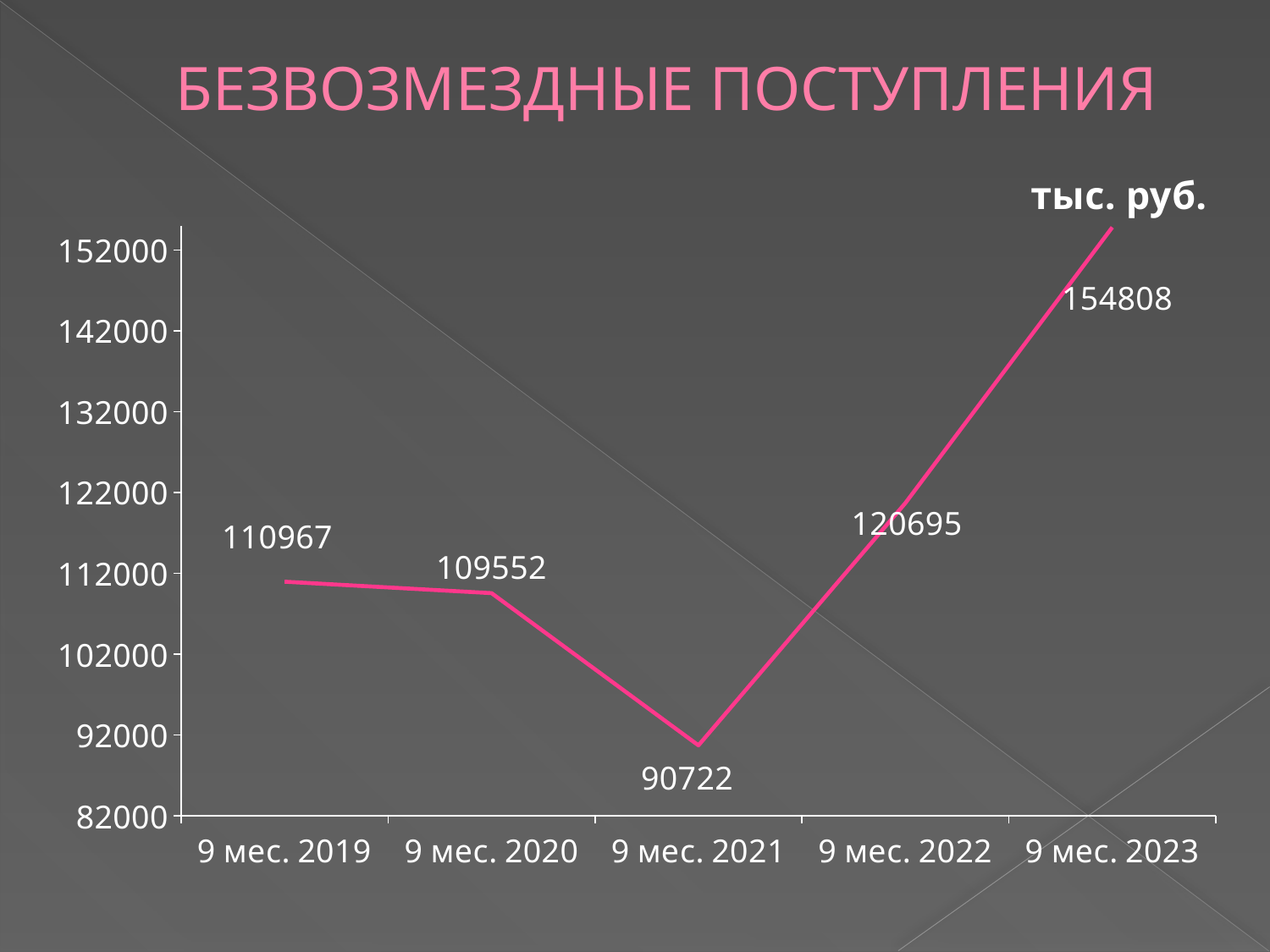
Which period has the lowest value? 9 мес. 2021 What is the difference between the values for 9 мес. 2023 and 9 мес. 2022? 34113 Which period has the highest value? 9 мес. 2023 What is the value for 9 мес. 2021? 90722 How many periods are plotted on the x axis? 5 What is the value for 9 мес. 2019? 110967 Which is larger, the value for 9 мес. 2022 or the value for 9 мес. 2020? 9 мес. 2022 What is the value for 9 мес. 2023? 154808 What is the difference between the values for 9 мес. 2019 and 9 мес. 2020? 1415 Is the value for 9 мес. 2021 greater or less than 92000? less What unit is indicated for the values on the chart? тыс. руб. What kind of chart is shown on the slide? line chart